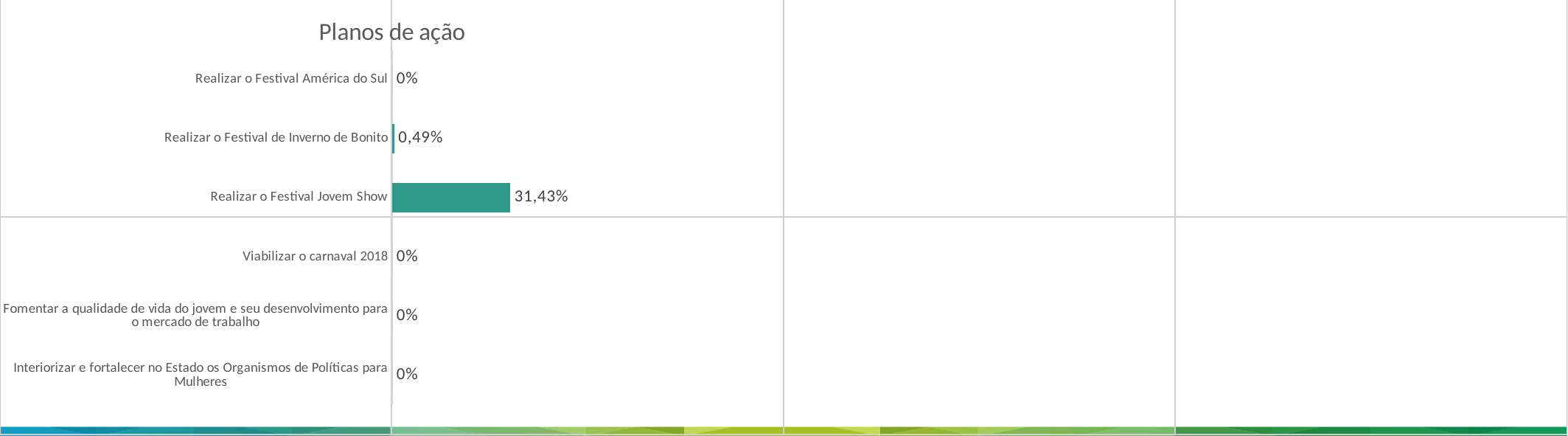
What is the value for Interiorizar e fortalecer no Estado os Organismos de Políticas para Mulheres? 0% How many categories are shown in the chart? 6 What kind of chart is shown on the slide? Bar chart What is the value for Realizar o Festival de Inverno de Bonito? 0,49% Which category has the highest value? Realizar o Festival Jovem Show What is the title of the chart? Planos de ação What is the difference between the values for Realizar o Festival Jovem Show and Realizar o Festival de Inverno de Bonito? 30,94% How many categories have a value of 0%? 4 What is the value for Realizar o Festival Jovem Show? 31,43% What is the value for Realizar o Festival América do Sul? 0% Which is larger, the value for Realizar o Festival de Inverno de Bonito or the value for Realizar o Festival Jovem Show? Realizar o Festival Jovem Show What is the value for Viabilizar o carnaval 2018? 0%